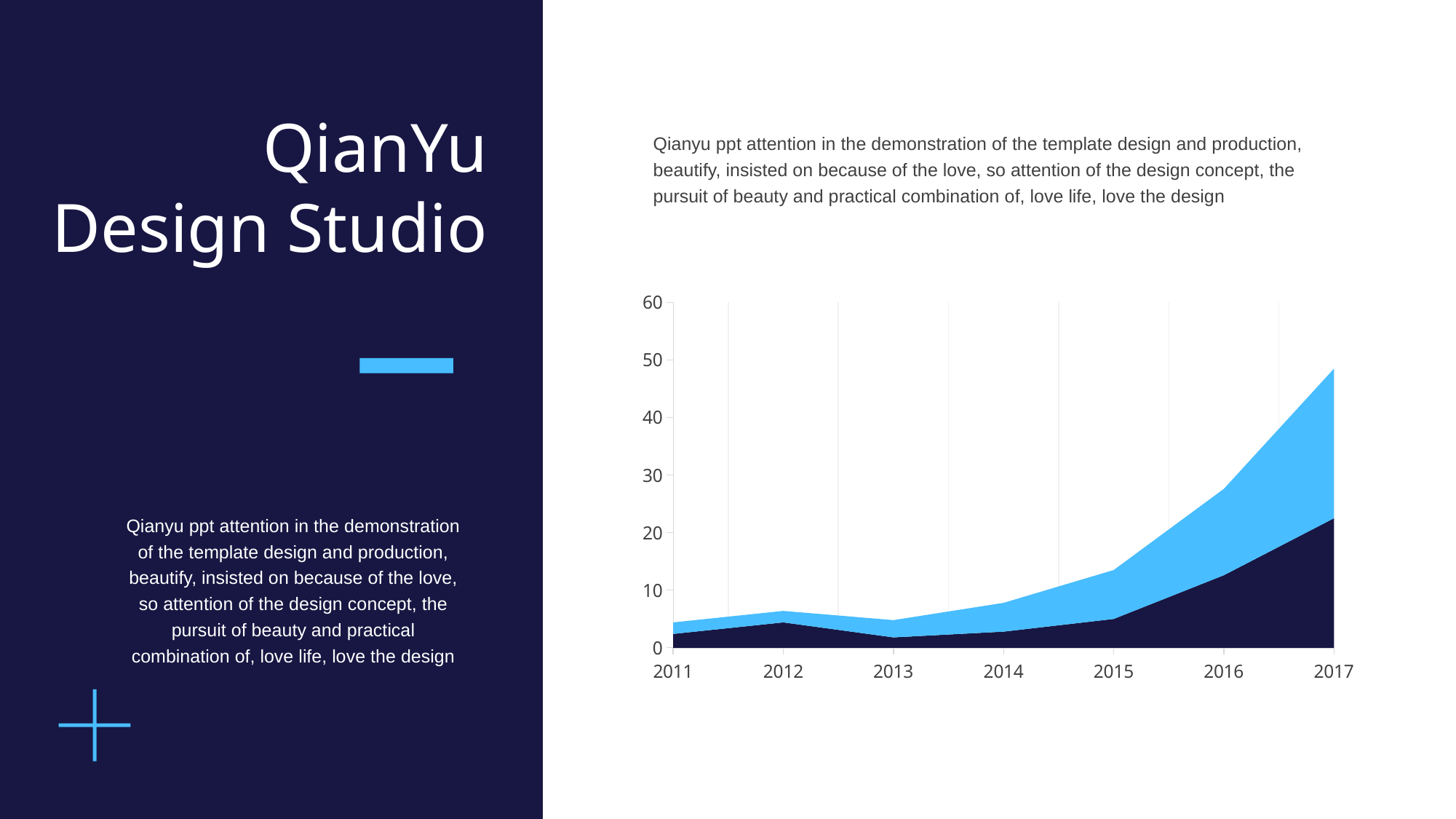
Is the stacked total for 2016 greater or less than 20? greater How many years are shown on the x axis of the chart? 7 Do the stacked totals rise or fall from 2013 to 2017? rise What is the highest value shown on the chart's y axis? 60 Is the stacked total for 2015 greater or less than 10? greater Which year has the larger stacked total, 2011 or 2017? 2017 Which year has the highest stacked total in the chart? 2017 Is the stacked total for 2011 greater or less than 10? less What kind of chart is shown on the slide? Area chart